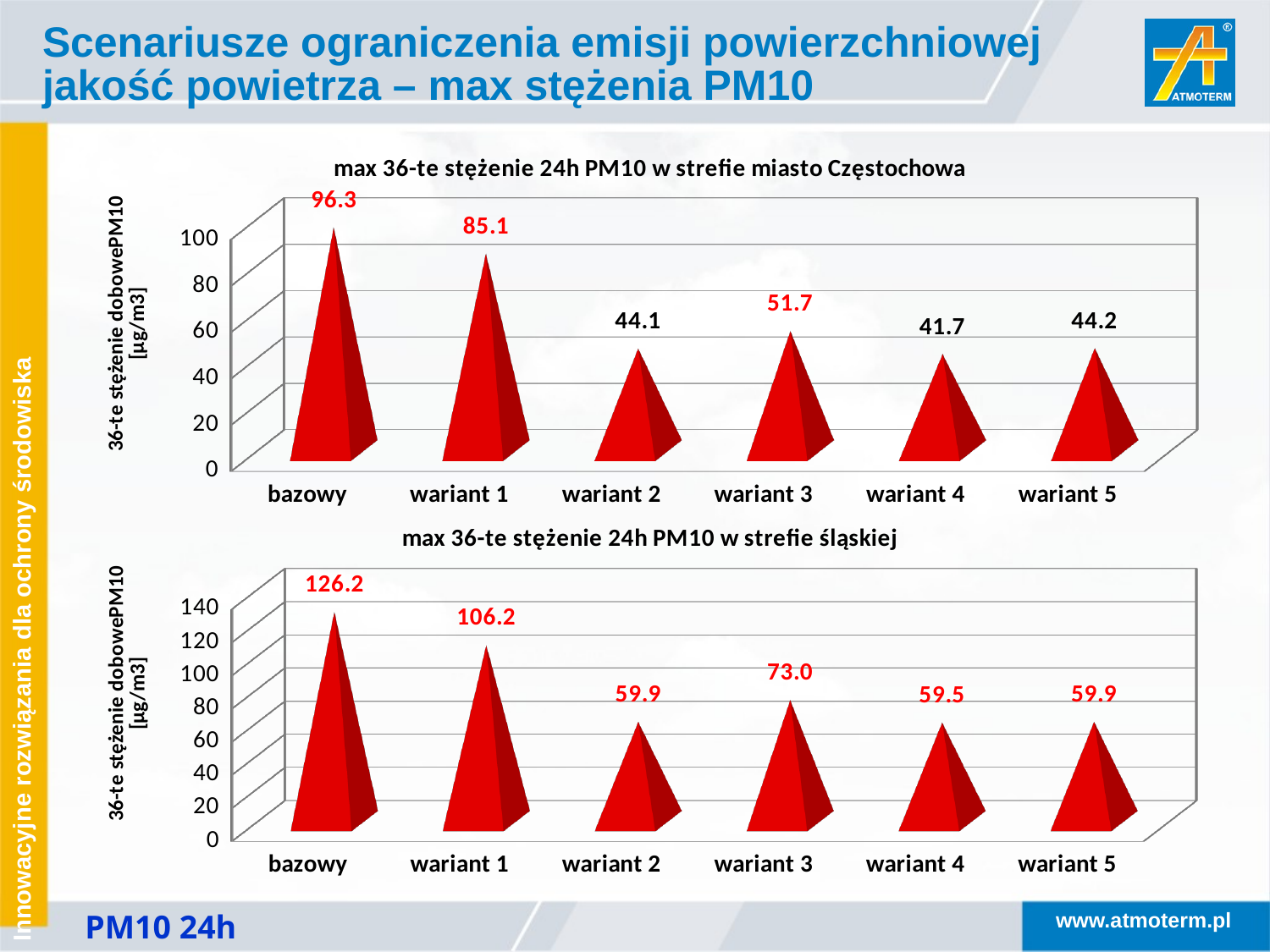
In the chart titled 'max 36-te stężenie 24h PM10 w strefie śląskiej', which category has the highest value? bazowy What kind of chart is the bottom chart on the slide? bar chart What is the y-axis label of the top chart? 36-te stężenie dobowe PM10 [µg/m3] In the chart titled 'max 36-te stężenie 24h PM10 w strefie miasto Częstochowa', which category has the lowest value? wariant 4 In the chart titled 'max 36-te stężenie 24h PM10 w strefie miasto Częstochowa', what is the value for bazowy? 96.3 In the chart titled 'max 36-te stężenie 24h PM10 w strefie miasto Częstochowa', what is the difference between bazowy and wariant 1? 11.2 In the chart titled 'max 36-te stężenie 24h PM10 w strefie śląskiej', what is the difference between bazowy and wariant 3? 53.2 In the chart titled 'max 36-te stężenie 24h PM10 w strefie śląskiej', what is the value for wariant 4? 59.5 In the chart titled 'max 36-te stężenie 24h PM10 w strefie śląskiej', which is larger: wariant 3 or wariant 2? wariant 3 In the chart titled 'max 36-te stężenie 24h PM10 w strefie miasto Częstochowa', what is the value for wariant 3? 51.7 In the chart titled 'max 36-te stężenie 24h PM10 w strefie miasto Częstochowa', how many categories are shown on the x axis? 6 In the chart titled 'max 36-te stężenie 24h PM10 w strefie śląskiej', what is the value for bazowy? 126.2